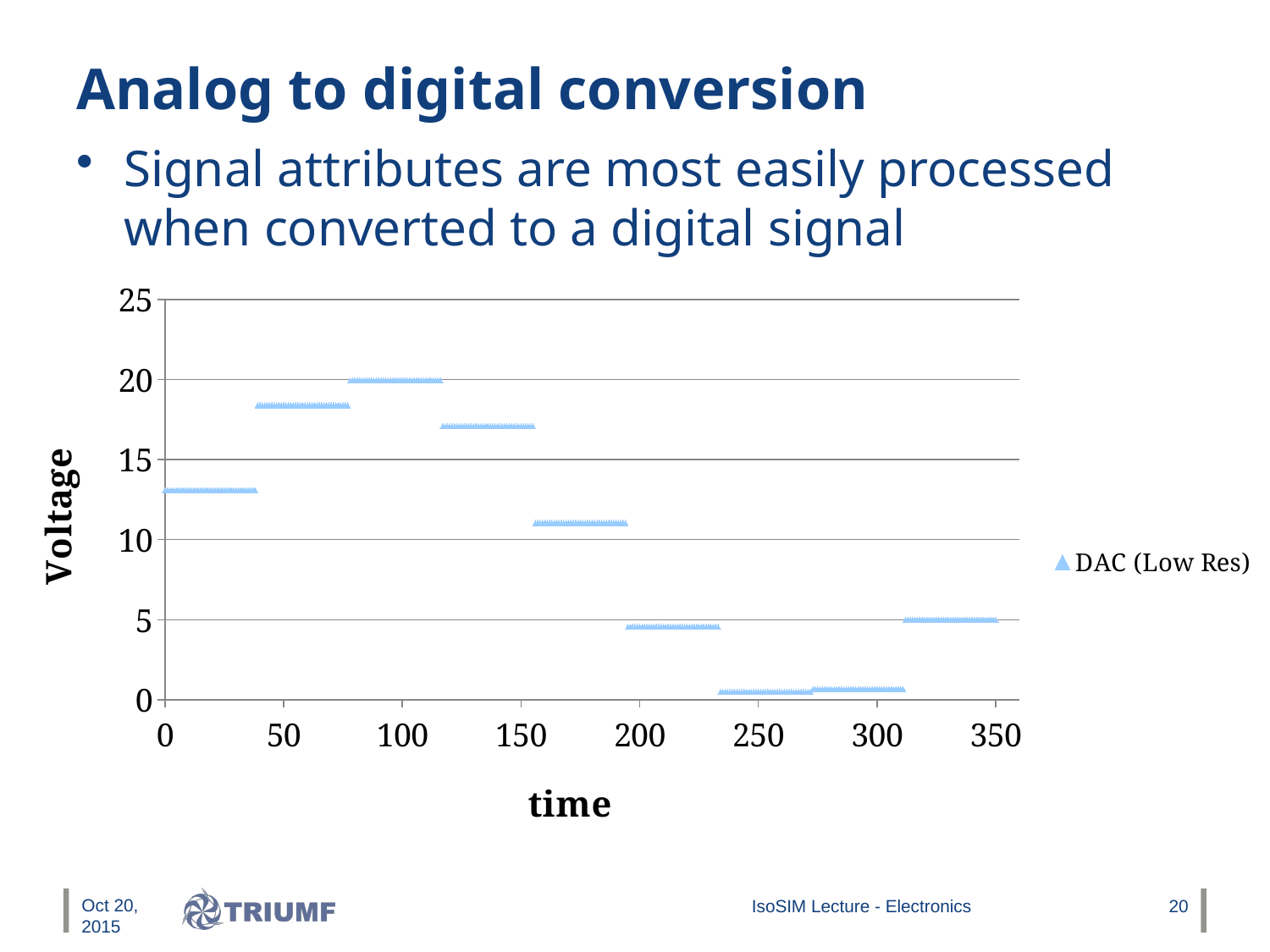
Is the voltage value at time 250 greater or less than 5? less Is the voltage value at time 60 greater or less than 15? greater Is the voltage value at time 20 greater or less than 10? greater What kind of chart is shown on the slide? scatter chart How many series does the legend list? 1 Which is larger, the voltage at time 20 or the voltage at time 175? time 20 What is the label of the vertical axis? Voltage Which is larger, the voltage at time 100 or the voltage at time 250? time 100 What is the name of the series shown in the legend? DAC (Low Res)